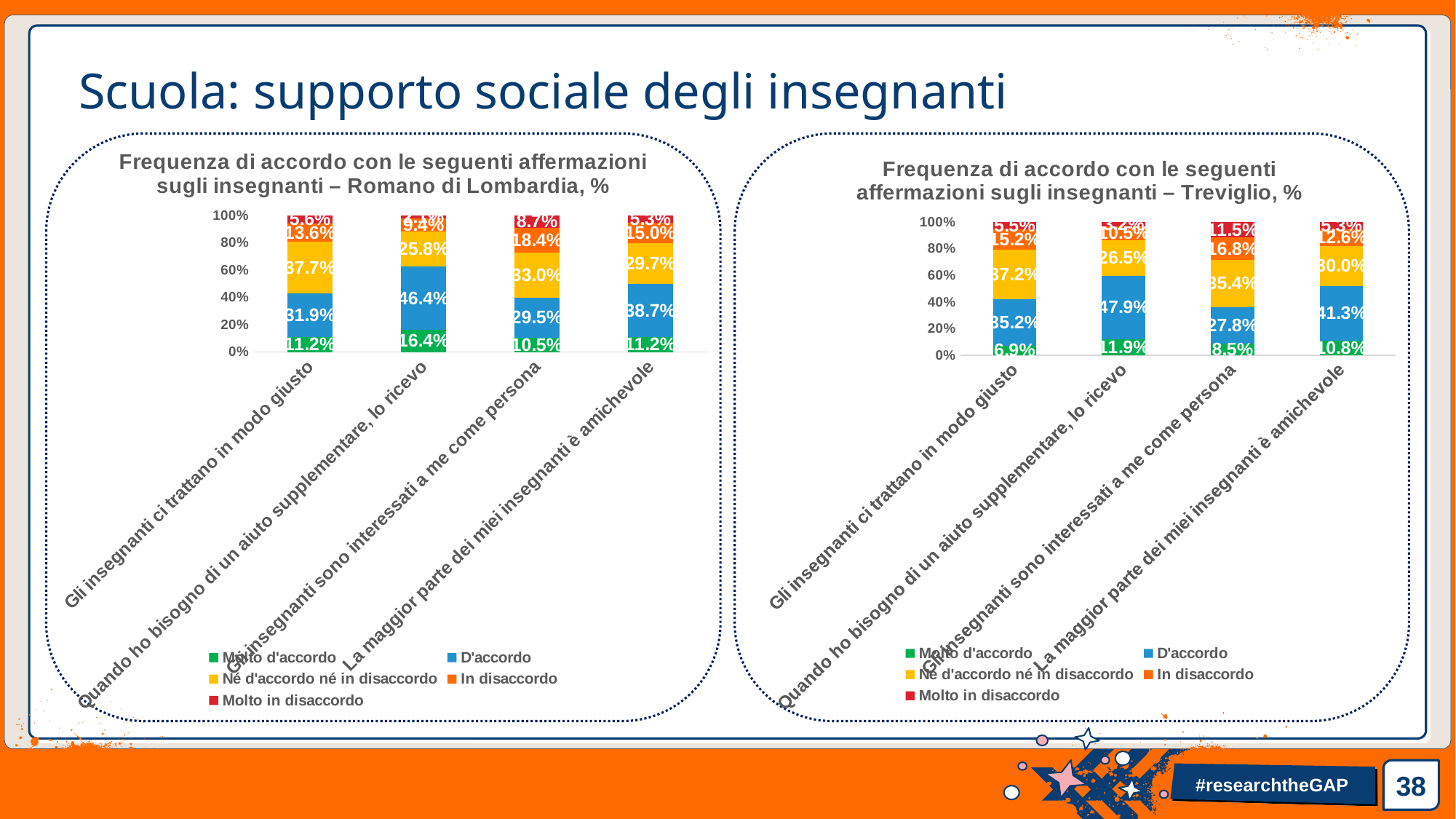
In the Romano di Lombardia chart, which is larger: the "Molto in disaccordo" value for "Gli insegnanti sono interessati a me come persona" or for "Gli insegnanti ci trattano in modo giusto"? Gli insegnanti sono interessati a me come persona What type of chart is used in the Treviglio chart? Stacked bar chart In the Treviglio chart, what is the "In disaccordo" value for "La maggior parte dei miei insegnanti è amichevole"? 12.6% In the Treviglio chart, what is the difference between the "D'accordo" values for "La maggior parte dei miei insegnanti è amichevole" and "Gli insegnanti sono interessati a me come persona"? 13.5% In the Romano di Lombardia chart, what percentage of respondents answered "D'accordo" to "Quando ho bisogno di un aiuto supplementare, lo ricevo"? 46.4% How many series does the legend of the Romano di Lombardia chart list? 5 In the Treviglio chart, which statement has the highest "D'accordo" share? Quando ho bisogno di un aiuto supplementare, lo ricevo In the Treviglio chart, what percentage answered "Molto d'accordo" to "Gli insegnanti ci trattano in modo giusto"? 6.9% In the Romano di Lombardia chart, which statement has the lowest "Molto d'accordo" share? Gli insegnanti sono interessati a me come persona In the Romano di Lombardia chart, which colour represents "Molto in disaccordo"? Red How many statements (categories) are shown in the Treviglio chart? 4 In the Romano di Lombardia chart, what is the "Né d'accordo né in disaccordo" value for "Gli insegnanti sono interessati a me come persona"? 33.0%